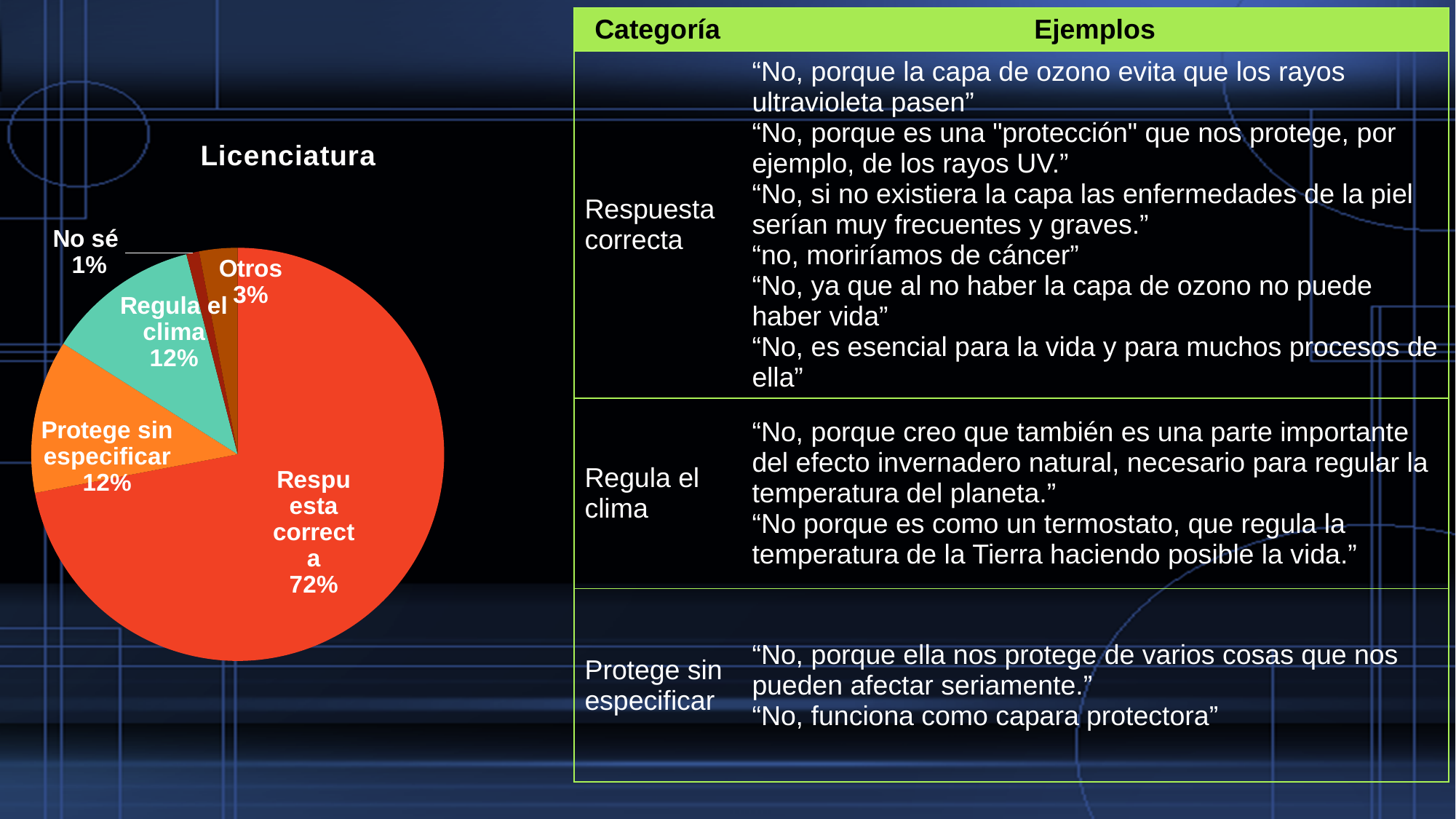
What percentage is shown for "Otros"? 3% What is the title of the pie chart? Licenciatura How many slices does the pie chart have? 5 Which is larger, the slice for "Otros" or the slice for "No sé"? Otros Which category has the largest slice of the pie? Respuesta correcta What is the difference in percentage points between "Respuesta correcta" and "Regula el clima"? 60 What kind of chart is shown on the slide? Pie chart What share of the pie does "Respuesta correcta" represent? 72% What percentage is shown for "No sé"? 1% Which category has the smallest slice of the pie? No sé What percentage is shown for "Protege sin especificar"? 12% What percentage is shown for "Regula el clima"? 12%